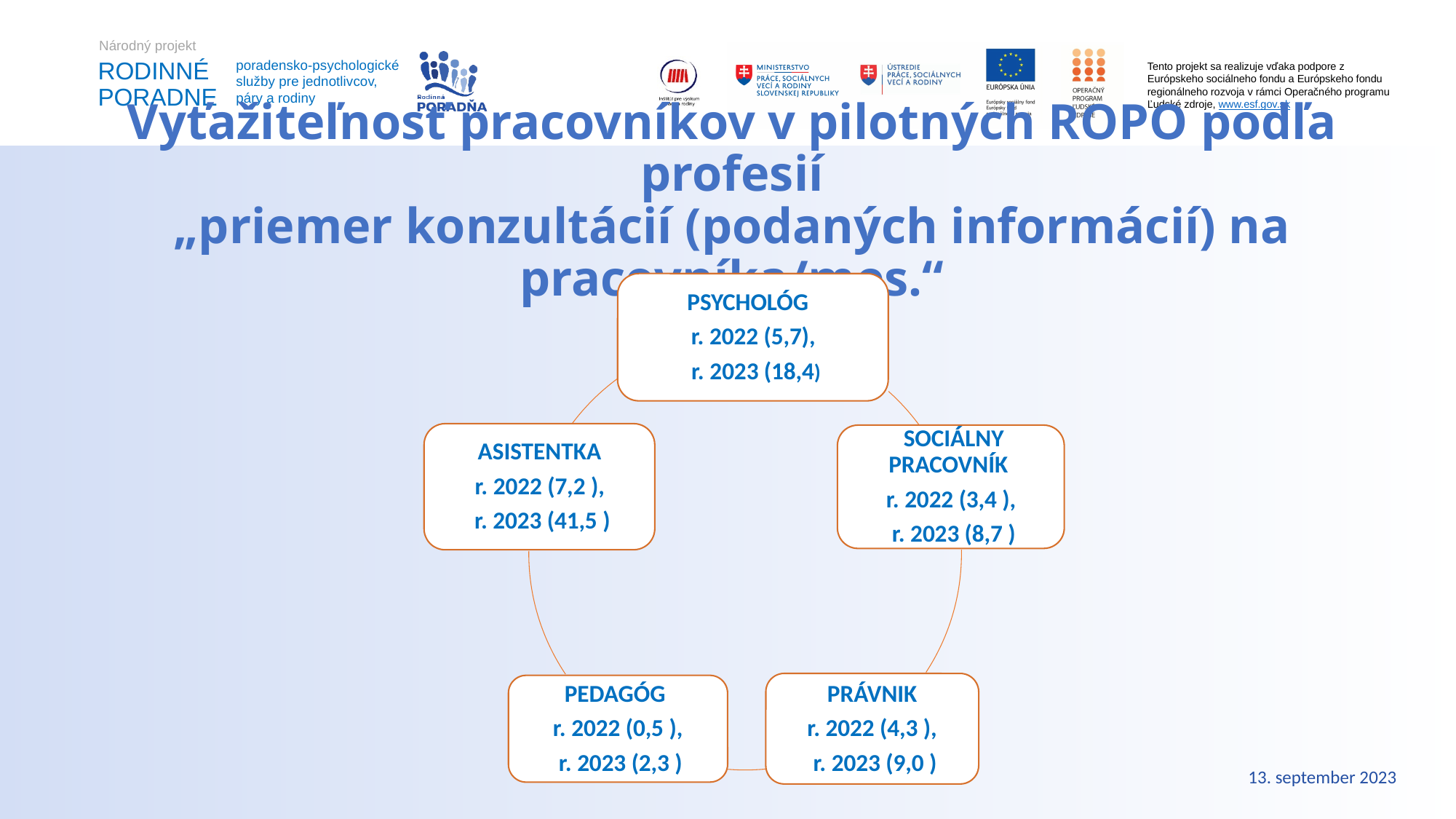
Which profession has the highest 2023 value? ASISTENTKA What is the 2023 value shown for PSYCHOLÓG? 18,4 What is the 2022 value shown for ASISTENTKA? 7,2 What is the 2023 value shown for SOCIÁLNY PRACOVNÍK? 8,7 Which profession is shown at the top of the cycle diagram? PSYCHOLÓG By how much did the value for ASISTENTKA increase from 2022 to 2023? 34,3 Which is larger: the 2022 value for PRÁVNIK or the 2022 value for SOCIÁLNY PRACOVNÍK? PRÁVNIK How many professions are shown in the diagram? 5 What is the difference between the 2023 and 2022 values for PSYCHOLÓG? 12,7 Which profession has the lowest 2022 value? PEDAGÓG What is the 2022 value shown for PEDAGÓG? 0,5 What is the 2023 value shown for PRÁVNIK? 9,0